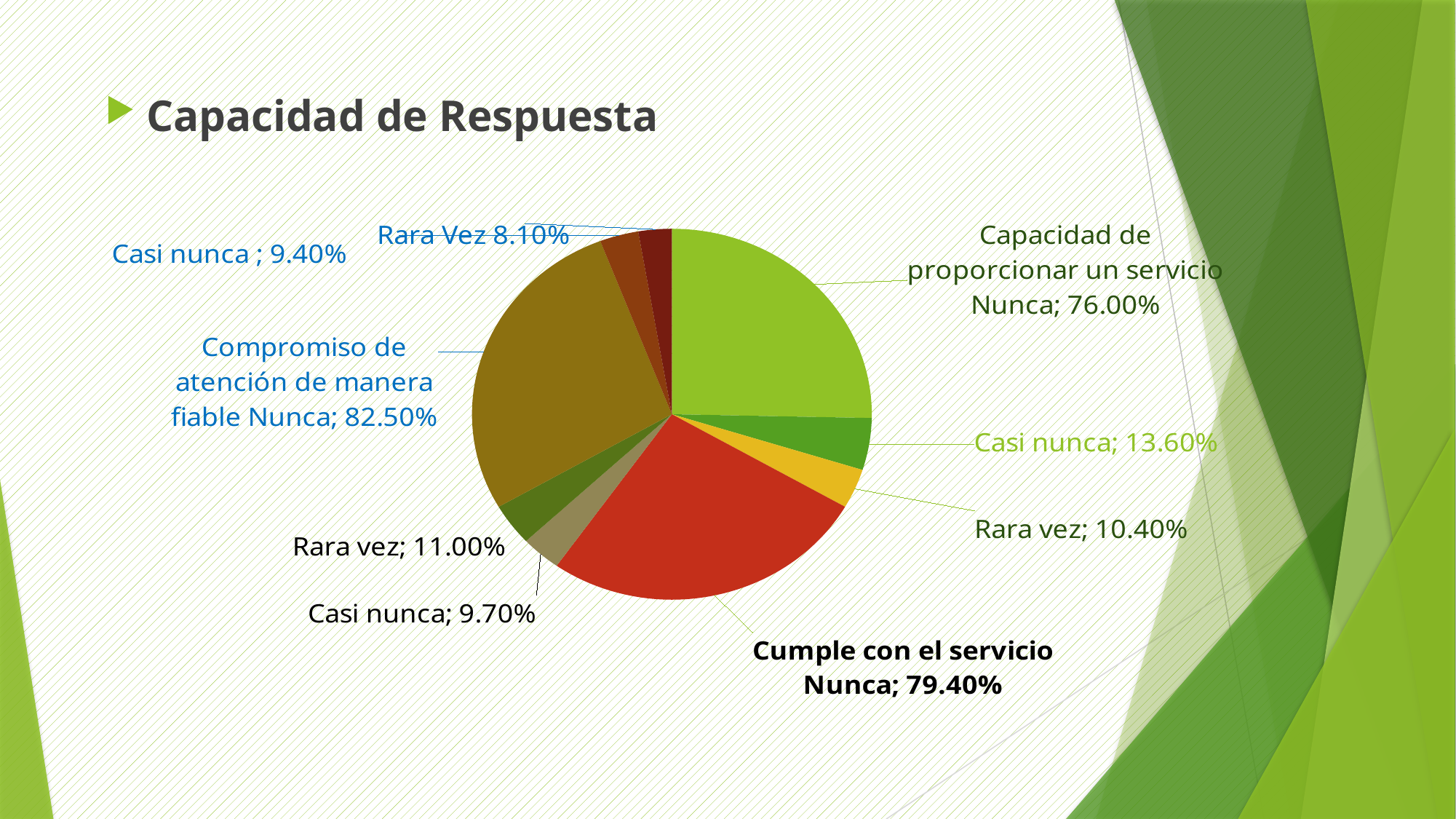
Which is larger: the value for "Capacidad de proporcionar un servicio Nunca" or the value for "Cumple con el servicio Nunca"? Cumple con el servicio Nunca What is the difference between the values for "Compromiso de atención de manera fiable Nunca" and "Cumple con el servicio Nunca"? 3.10% What is the value labelled for "Compromiso de atención de manera fiable Nunca"? 82.50% What value is shown for the "Rara Vez" slice labelled in blue at the top of the pie? 8.10% What kind of chart is shown on the slide? pie chart What value is shown for the "Casi nunca" slice labelled in green on the right side of the pie? 13.60% What is the title of the slide? Capacidad de Respuesta Which labelled slice has the smallest value? Rara Vez 8.10% What is the value labelled for "Cumple con el servicio Nunca"? 79.40% Which labelled slice has the largest value? Compromiso de atención de manera fiable Nunca; 82.50% How many slices does the pie chart have? 9 What is the value labelled for "Capacidad de proporcionar un servicio Nunca"? 76.00%